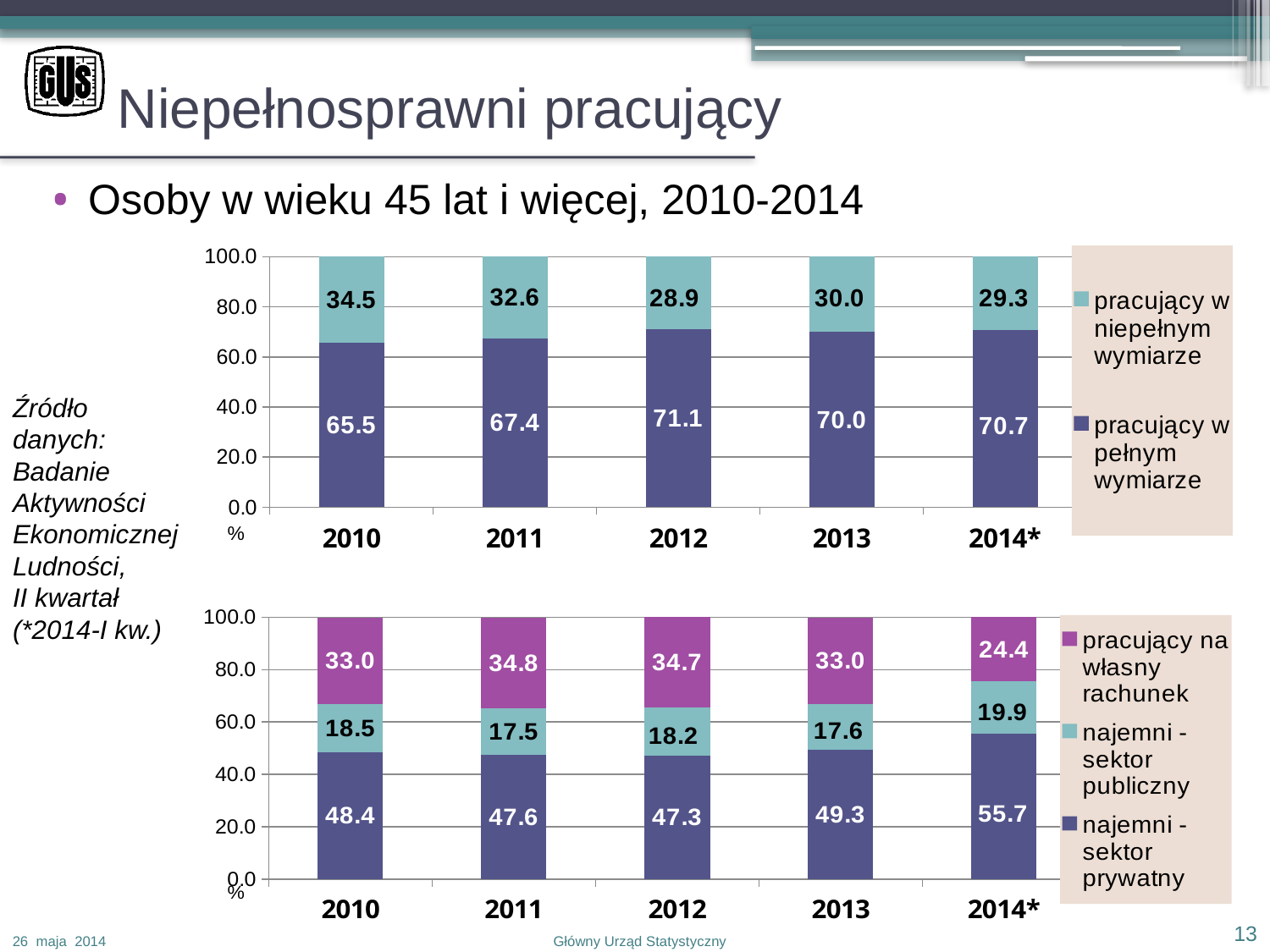
In the bottom chart, what is the value for 'najemni - sektor prywatny' in 2014*? 55.7 How many series does the legend of the top chart list? 2 In the top chart, what is the value for 'pracujący w niepełnym wymiarze' in 2010? 34.5 In the bottom chart, is the value for 'najemni - sektor prywatny' in 2013 larger or smaller than in 2012? larger In the bottom chart, what is the total of the stacked bar for 2010? 99.9 In the top chart, what is the difference between the 'pracujący w pełnym wymiarze' values for 2012 and 2010? 5.6 In the top chart, which year has the highest value for 'pracujący w niepełnym wymiarze'? 2010 In the bottom chart, which year has the lowest value for 'pracujący na własny rachunek'? 2014* In the top chart, what is the value for 'pracujący w pełnym wymiarze' in 2012? 71.1 What type of chart is the bottom chart? stacked bar chart How many years are shown on the x axis of the bottom chart? 5 In the bottom chart, what is the value for 'najemni - sektor publiczny' in 2011? 17.5